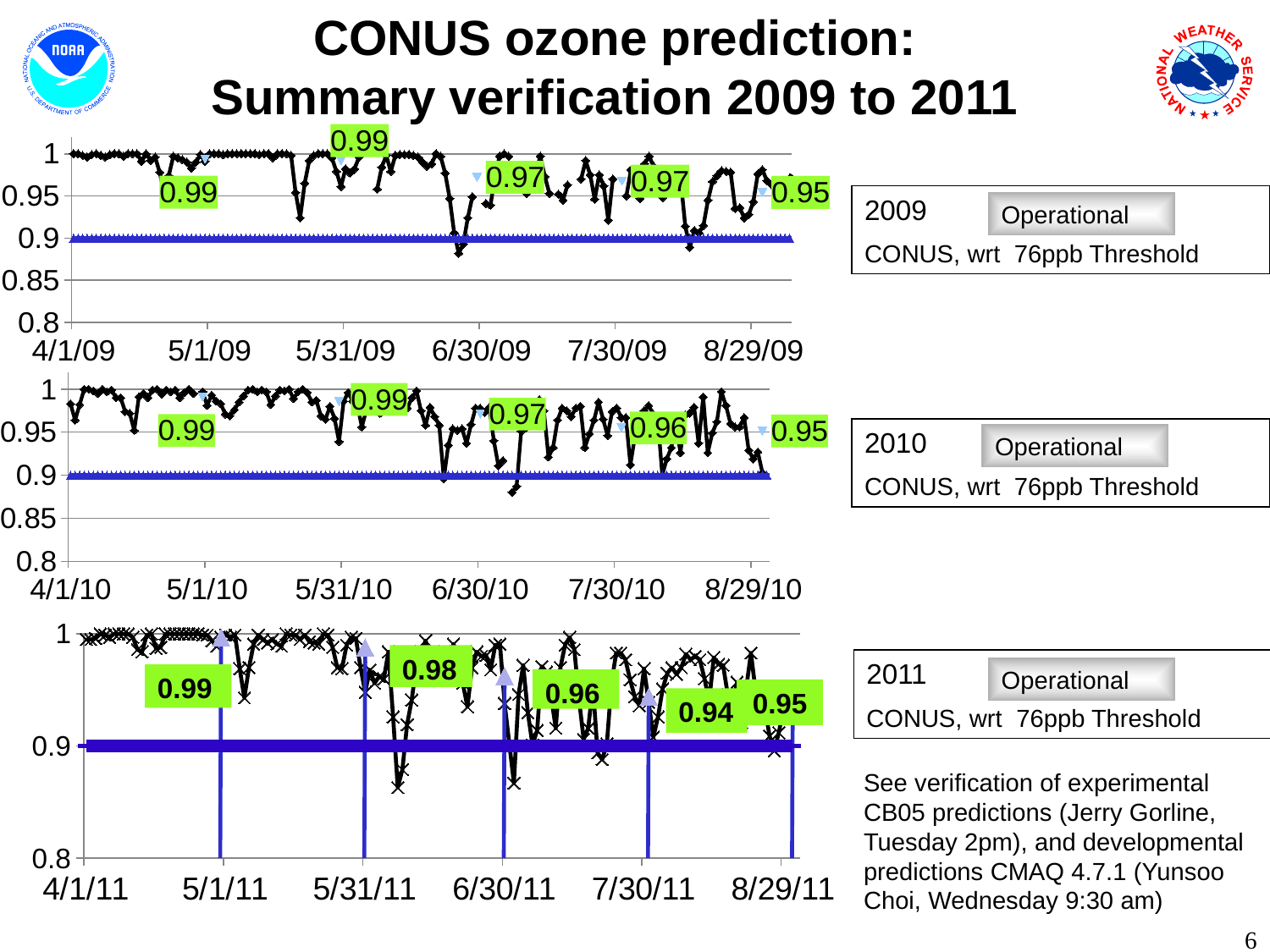
How many charts are shown on the slide? 3 In the 2011 chart (bottom), what is the difference between the first labeled value (0.99) and the labeled value near 7/30/11 (0.94)? 0.05 In the 2011 chart (bottom), which labeled value is the lowest? 0.94 In the 2011 chart (bottom), what is the first labeled value, near 5/1/11? 0.99 In the 2010 chart (middle), which is larger: the labeled value near 6/30/10 or the labeled value near 8/29/10? the value near 6/30/10 (0.97) In the 2011 chart (bottom), what is the labeled value near 7/30/11? 0.94 At what y-axis value is the thick horizontal reference line drawn in each chart? 0.9 In the 2009 chart (top), what is the labeled value near 6/30/09? 0.97 In the 2010 chart (middle), what is the last labeled value, near 8/29/10? 0.95 What is the first date shown on the x axis of the 2010 chart (middle)? 4/1/10 In the 2009 chart (top), do the labeled values generally rise or fall from April to August? fall What kind of chart is the top chart (2009)? line chart